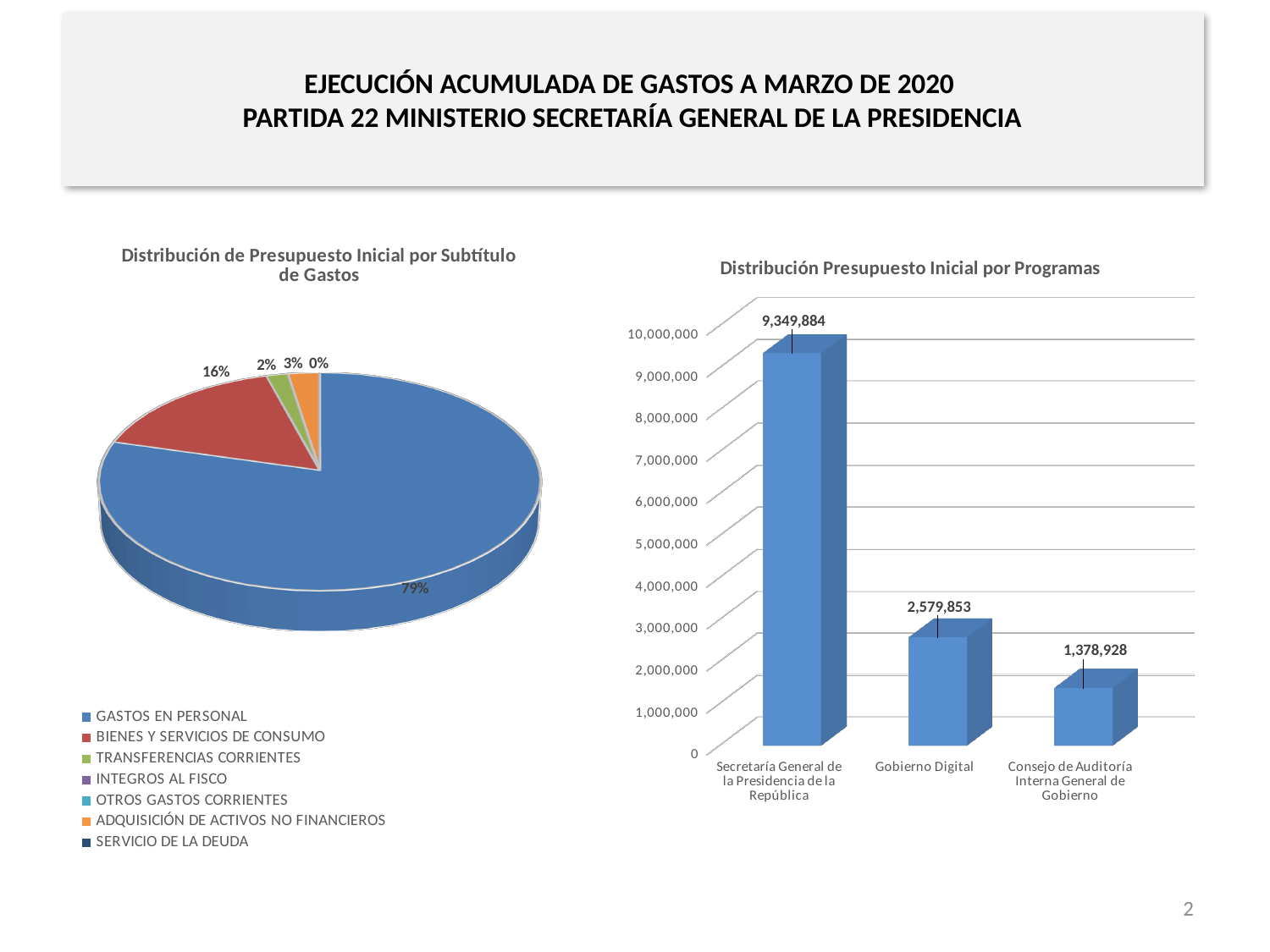
In the 'Distribución Presupuesto Inicial por Programas' chart, what is the difference between Gobierno Digital and Consejo de Auditoría Interna General de Gobierno? 1,200,925 In the 'Distribución Presupuesto Inicial por Programas' chart, which program has the highest value? Secretaría General de la Presidencia de la República In the 'Distribución de Presupuesto Inicial por Subtítulo de Gastos' pie chart, what share does GASTOS EN PERSONAL have? 79% In the 'Distribución Presupuesto Inicial por Programas' chart, what is the value for Gobierno Digital? 2,579,853 In the 'Distribución de Presupuesto Inicial por Subtítulo de Gastos' pie chart, which category has the largest share? GASTOS EN PERSONAL In the 'Distribución de Presupuesto Inicial por Subtítulo de Gastos' pie chart, what share does BIENES Y SERVICIOS DE CONSUMO have? 16% In the 'Distribución Presupuesto Inicial por Programas' chart, how many programs are shown? 3 In the 'Distribución Presupuesto Inicial por Programas' chart, which program has the lowest value? Consejo de Auditoría Interna General de Gobierno In the 'Distribución Presupuesto Inicial por Programas' chart, what is the value for Secretaría General de la Presidencia de la República? 9,349,884 How many entries does the legend of the 'Distribución de Presupuesto Inicial por Subtítulo de Gastos' pie chart list? 7 In the 'Distribución Presupuesto Inicial por Programas' chart, what is the value for Consejo de Auditoría Interna General de Gobierno? 1,378,928 What kind of chart is 'Distribución Presupuesto Inicial por Programas'? Bar chart